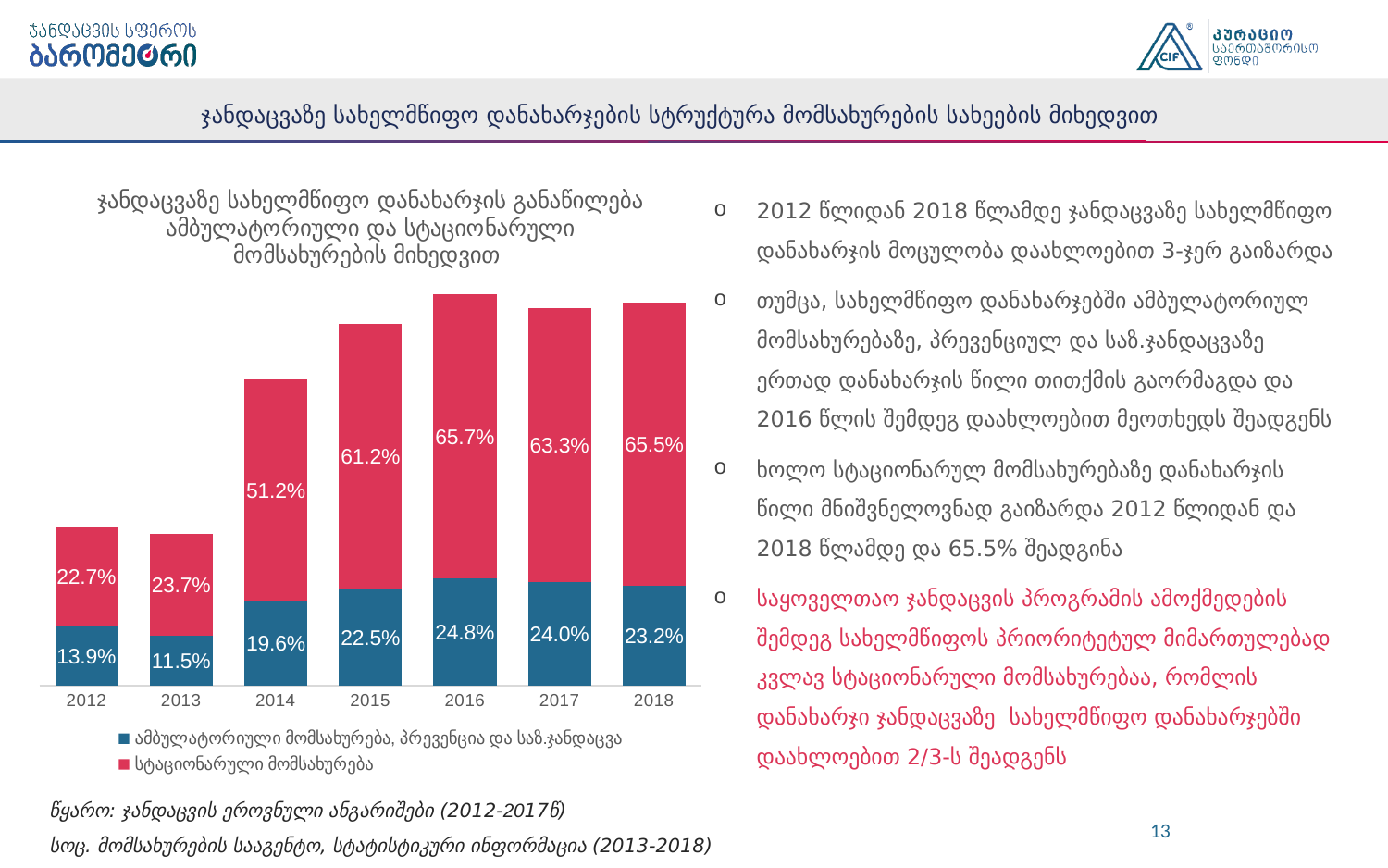
In which year is the red (stationary services) segment the highest? 2016 Does the red (stationary services) value generally rise or fall from 2012 to 2016? rise What is the value of the red (stationary services) segment for 2016? 65.7% What is the value of the blue (ambulatory services) segment for 2013? 11.5% What is the value of the red (stationary services) segment for 2018? 65.5% How many series does the chart legend list? 2 What is the total of the stacked bar for 2012? 36.6% What type of chart is shown on the slide? stacked bar chart How many years (categories) are shown on the x axis of the chart? 7 In which year is the blue (ambulatory services) segment the lowest? 2013 Which is larger: the blue (ambulatory services) value for 2016 or for 2018? 2016 What is the difference between the red (stationary services) values for 2014 and 2013? 27.5%